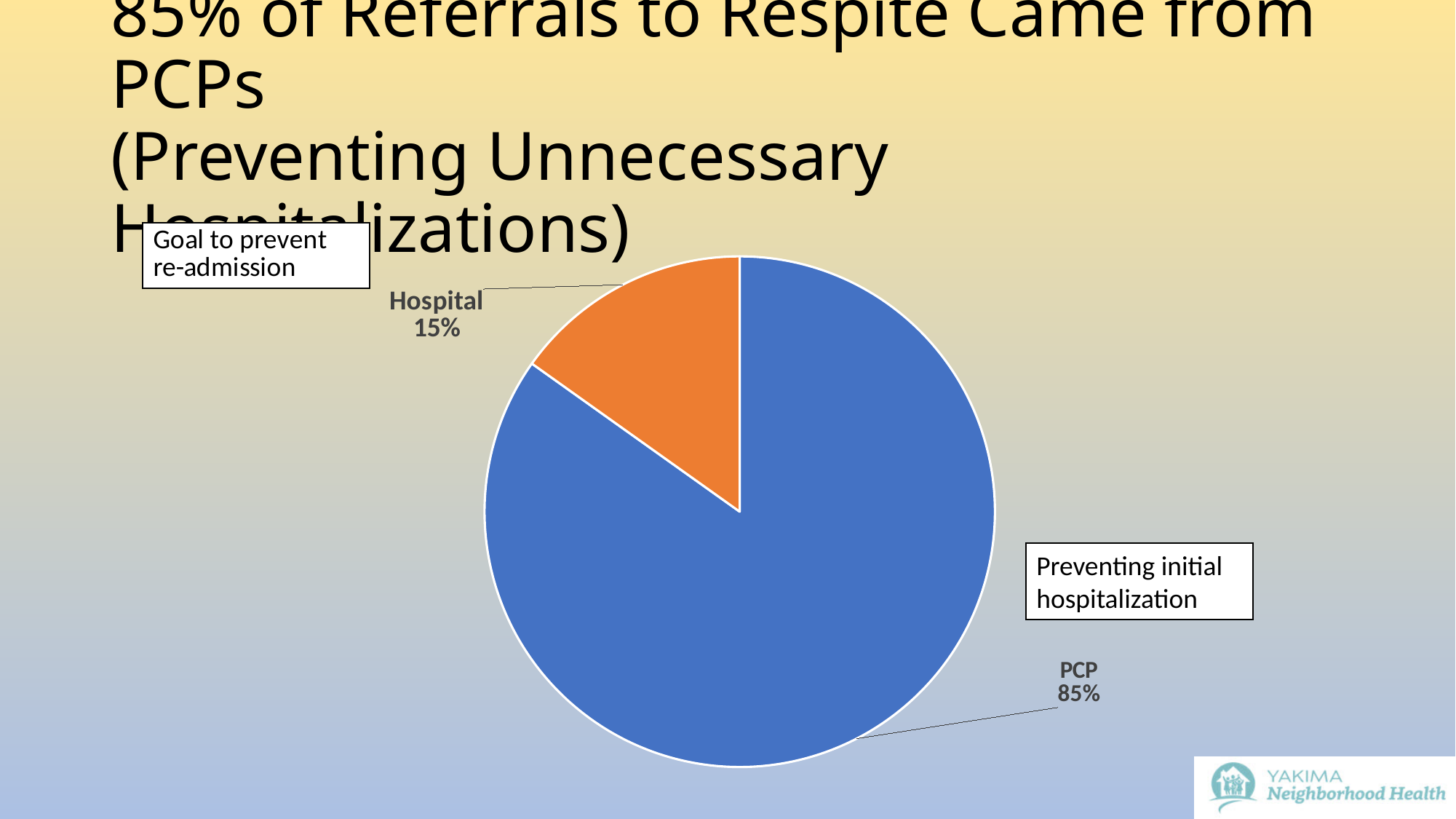
What is the total of the two slices shown in the pie chart? 100% What colour is the Hospital slice of the pie? orange Which referral source has the largest slice of the pie? PCP What share of referrals to respite came from the Hospital? 15% What colour is the PCP slice of the pie? blue How many slices does the pie chart have? 2 Which referral source has the smallest slice of the pie? Hospital Which is larger, the PCP slice or the Hospital slice? PCP What is the difference in percentage points between the PCP and Hospital slices? 70 What share of referrals to respite came from PCPs? 85% What kind of chart is shown on the slide? pie chart